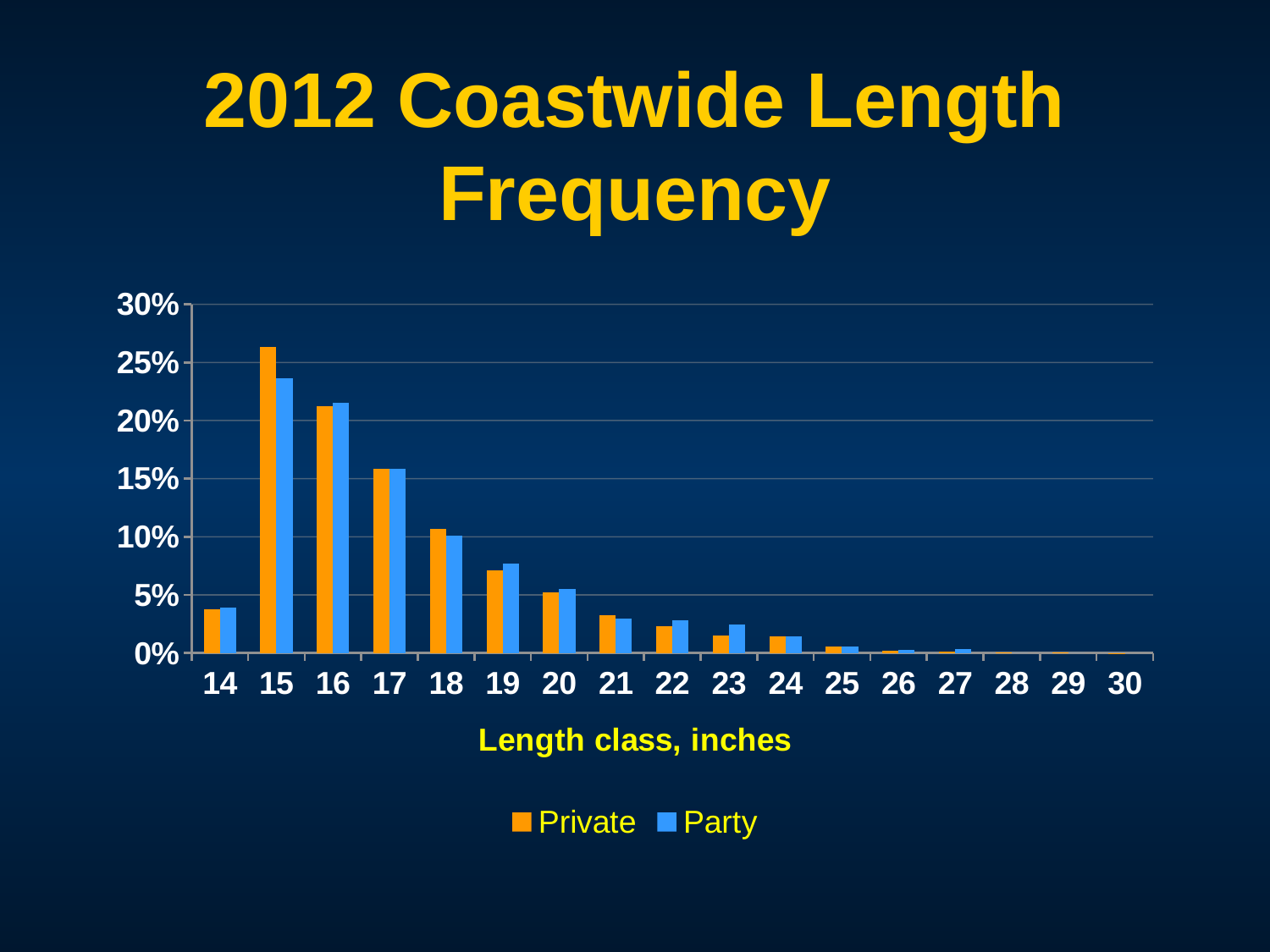
How many length classes are shown on the x axis? 17 At length class 23, which series has the larger value, Private or Party? Party Is the Private value for length class 15 greater or less than 25%? greater At length class 15, which series has the larger value, Private or Party? Private Is the Party value for length class 19 greater or less than 5%? greater How many series does the legend list? 2 What is the x-axis title of the chart? Length class, inches Is the Party value for length class 15 greater or less than 25%? less Which length class has the highest Private value? 15 Which length class has the highest Party value? 15 Do the Private values rise or fall from length class 15 to length class 30? fall What kind of chart is shown on the slide? bar chart